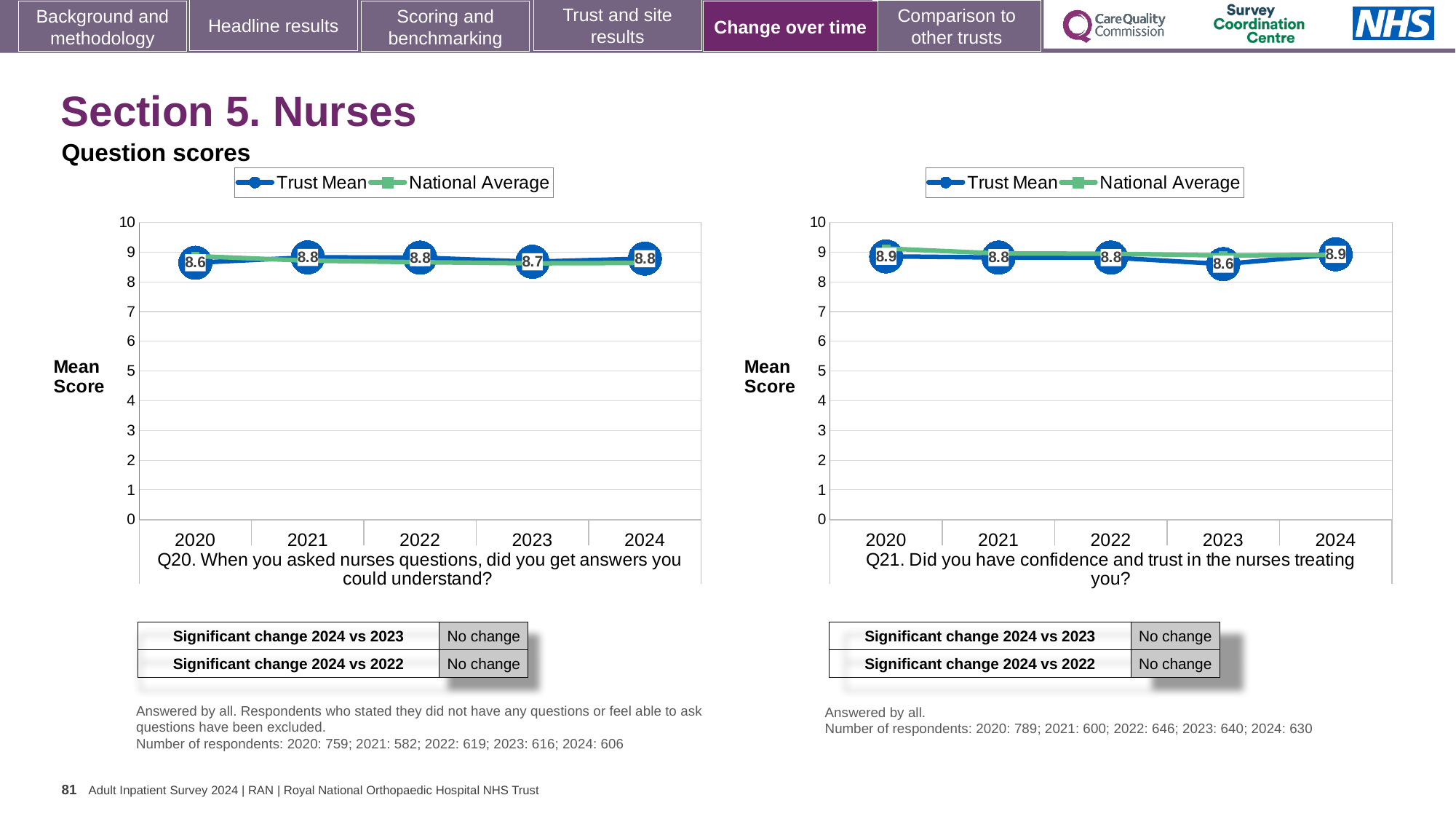
On the Q20 chart, what is the Trust Mean score for 2020? 8.6 What type of chart is used for Q21? Line chart How many series does the legend of the Q20 chart list? 2 On the Q20 chart, which year has the lowest Trust Mean score? 2020 On the Q20 chart, is the Trust Mean score for 2021 or 2020 higher? 2021 On the Q20 chart, what is the Trust Mean score for 2023? 8.7 How many years are plotted on the Q21 chart? 5 On the Q21 chart, what is the Trust Mean score for 2023? 8.6 On the Q21 chart, what is the Trust Mean score for 2024? 8.9 On the Q21 chart, what is the difference between the Trust Mean scores for 2024 and 2023? 0.3 On the Q21 chart, which year has the lowest Trust Mean score? 2023 On the Q20 chart, is the Trust Mean value for 2022 greater or less than 8? greater